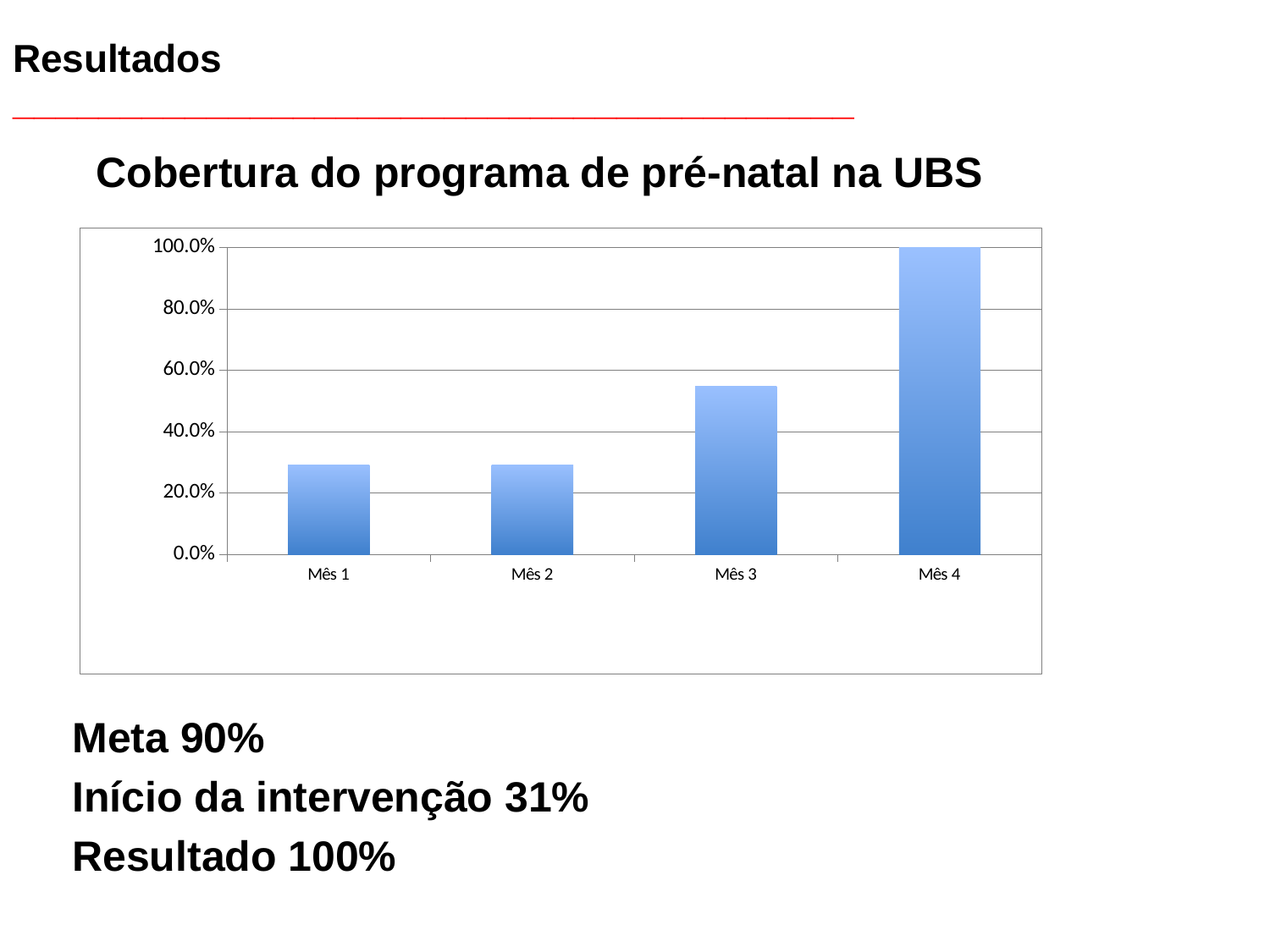
Is the value for Mês 4 greater or less than 80.0%? greater Is the value for Mês 1 greater or less than 40.0%? less Is the value for Mês 3 greater or less than 40.0%? greater How many categories (months) are plotted on the chart? 4 What is the title shown above the chart? Cobertura do programa de pré-natal na UBS What is the value for Mês 4? 100.0% What kind of chart is shown on the slide? Bar chart Do the values rise or fall from Mês 1 to Mês 4? Rise Which is larger, the value for Mês 3 or the value for Mês 1? Mês 3 Which month has the highest value on the chart? Mês 4